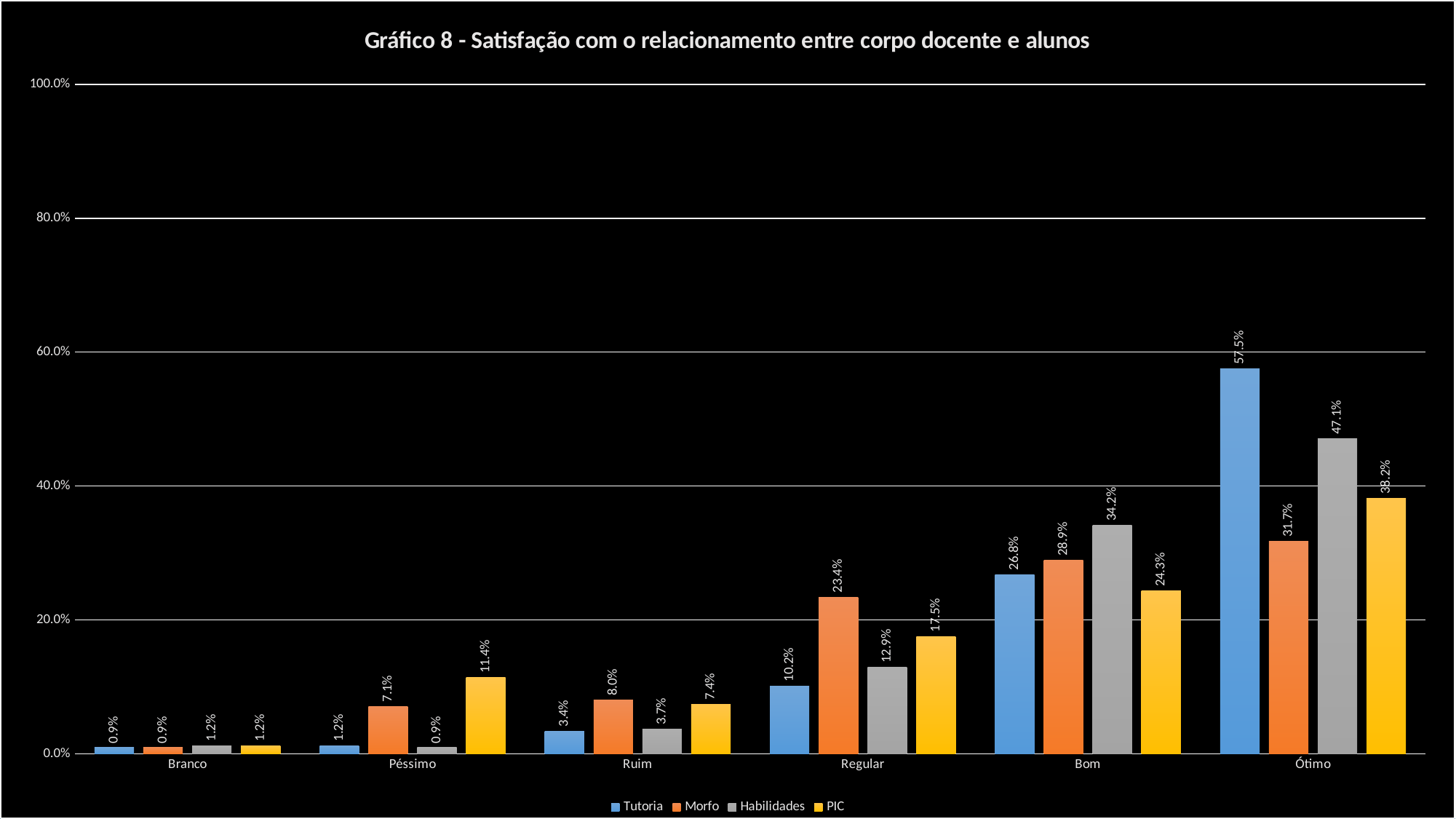
What is the value for PIC in the Péssimo category? 11.4% What is the value for Habilidades in the Bom category? 34.2% What is the difference between the Habilidades and Morfo values in the Ótimo category? 15.4% How many categories are shown on the x axis? 6 Which series has the lowest value in the Péssimo category? Habilidades How many series does the legend list? 4 Which series has the highest value in the Ótimo category? Tutoria What is the value for Tutoria in the Ótimo category? 57.5% What type of chart is shown on the slide? bar chart Is the value for Habilidades in the Ótimo category greater or less than 40.0%? greater What is the value for Morfo in the Regular category? 23.4% Which is larger in the Bom category: Tutoria or Morfo? Morfo